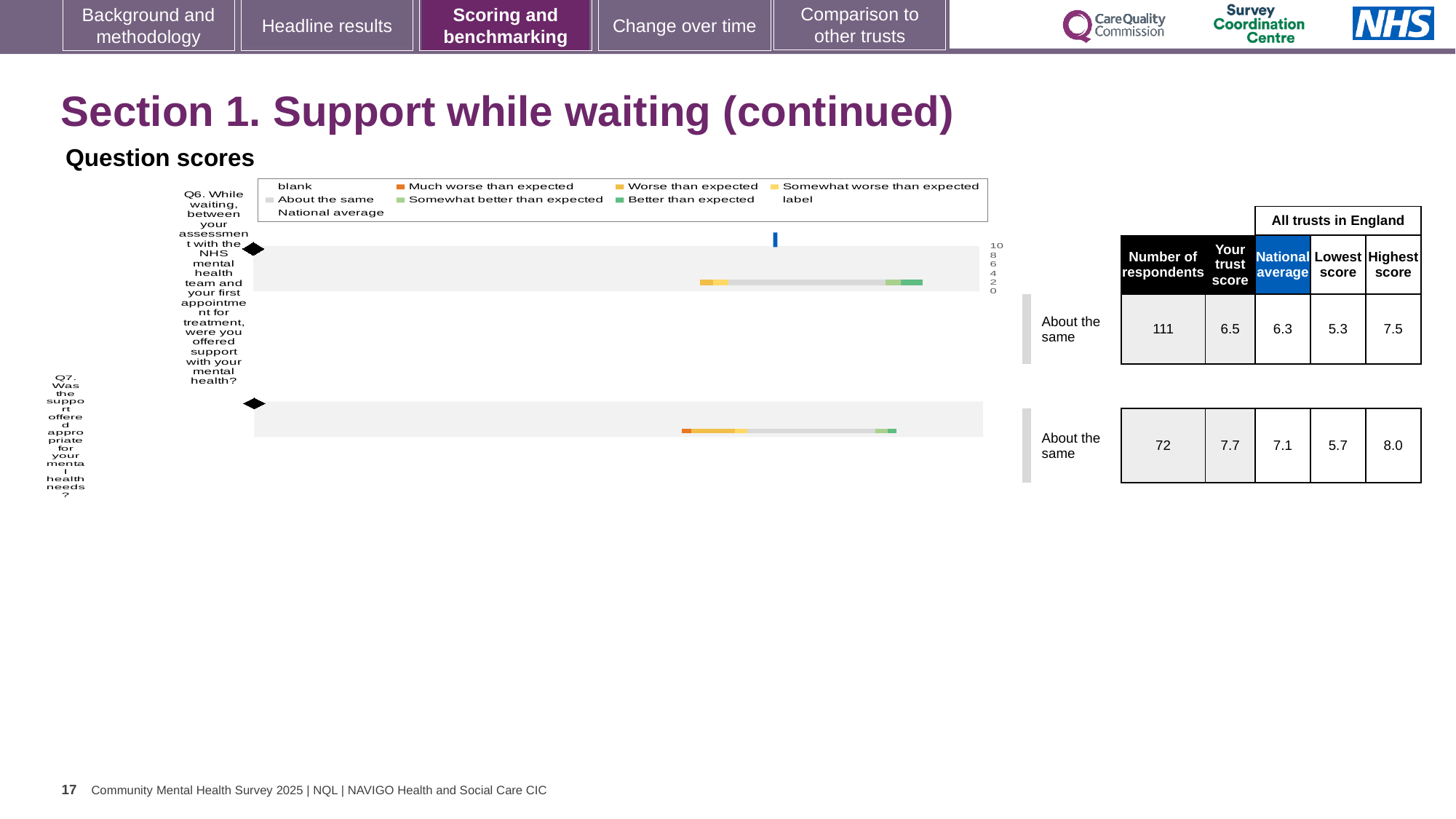
In the table beside the chart, what is the national average for Q6? 6.3 What kind of chart is shown under 'Question scores'? bar chart In the table beside the chart, what is the highest score among all trusts in England for Q7? 8.0 Which question has more respondents, Q6 or Q7? Q6 In the table beside the chart, what is the number of respondents for Q6? 111 What is the highest value shown on the chart's score axis? 10 For Q7, what is the difference between the highest score and the lowest score across all trusts in England? 2.3 In the table beside the chart, what is 'Your trust score' for Q7? 7.7 How many questions (bars) are plotted in the chart? 2 For Q7, which is larger: your trust score or the national average? Your trust score Which benchmark category is shown next to the bar for Q6? About the same In the table beside the chart, what is the lowest score among all trusts in England for Q6? 5.3